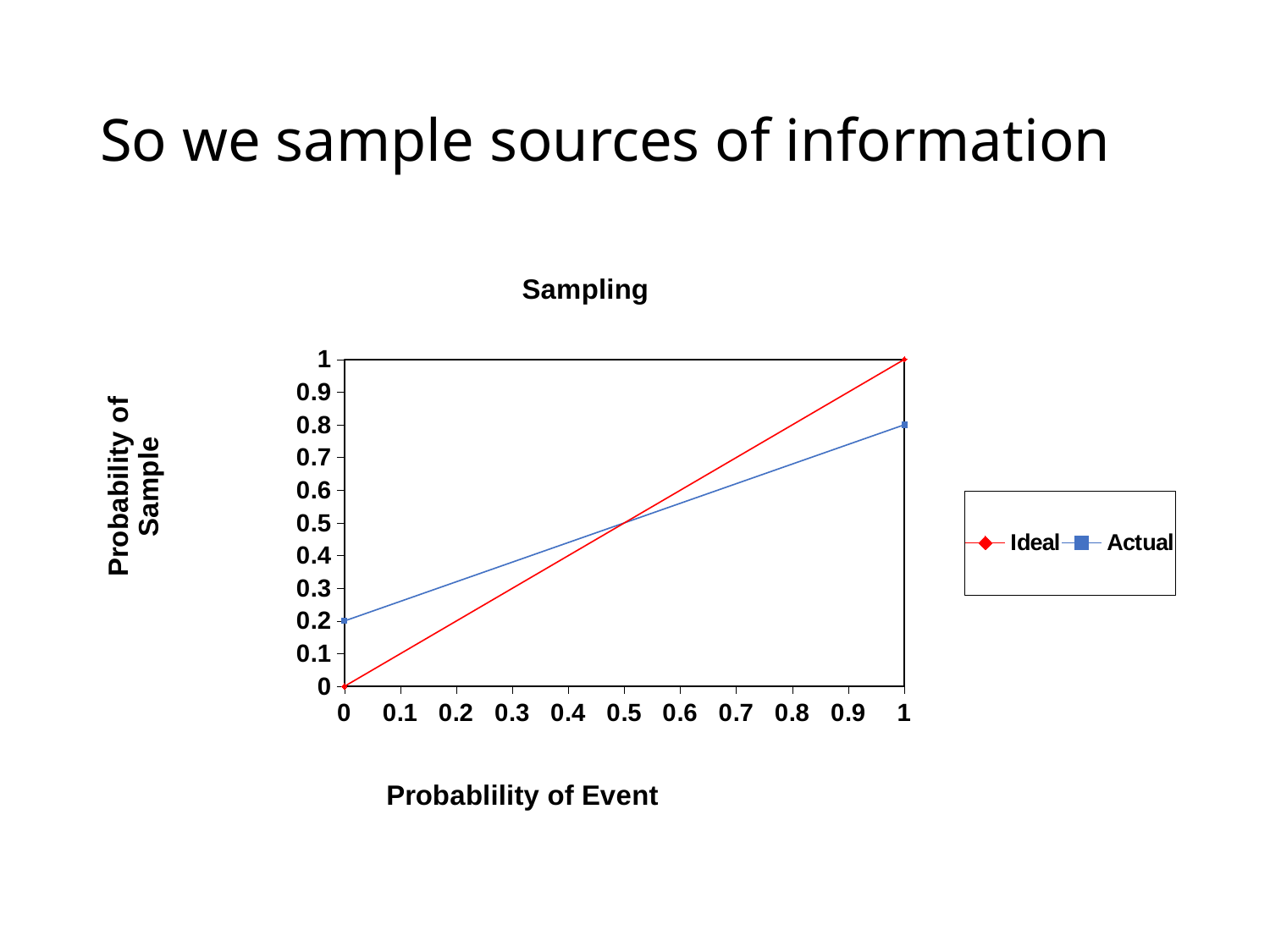
What is the title of the chart? Sampling What kind of chart is shown on the slide? line chart Does the Actual series rise or fall as the Probability of Event increases? rise What is the value of the Ideal series when the Probability of Event is 1? 1 Which series has the higher value when the Probability of Event is 0, Ideal or Actual? Actual How many series does the legend list? 2 Which series has the higher value when the Probability of Event is 1, Ideal or Actual? Ideal What are the names of the series in the legend? Ideal and Actual What is the value of the Actual series when the Probability of Event is 1? 0.8 What is the value of the Actual series when the Probability of Event is 0? 0.2 What is the difference between the Ideal and Actual values when the Probability of Event is 1? 0.2 What is the value of the Ideal series when the Probability of Event is 0? 0